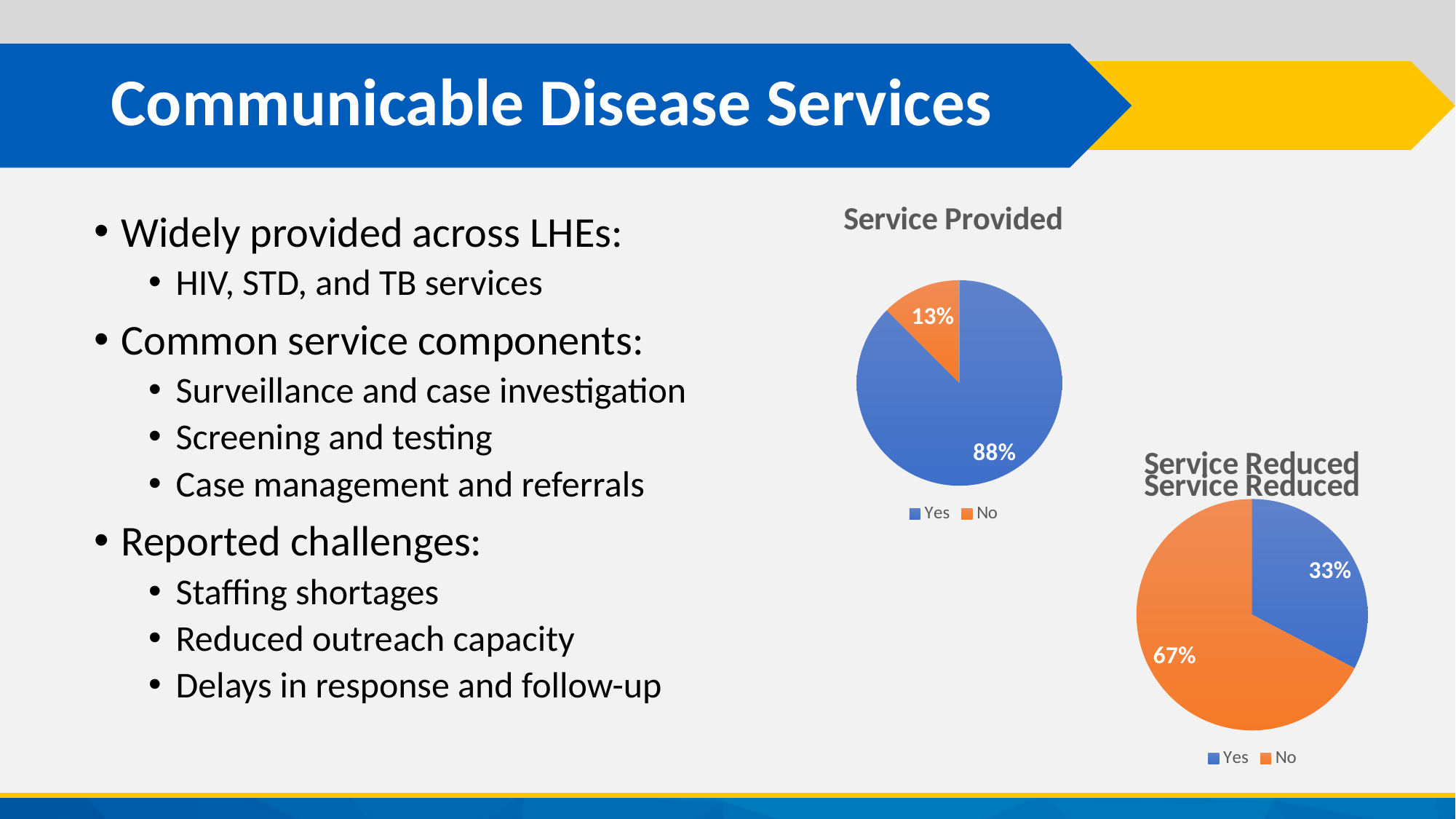
In the 'Service Provided' chart, what colour is the No slice? Orange In the 'Service Provided' chart, which slice is the largest? Yes What type of chart is the 'Service Provided' chart? Pie chart In the 'Service Provided' chart, what percentage is labelled for Yes? 88% In the 'Service Provided' chart, what is the difference in percentage points between the Yes and No slices? 75 In the 'Service Reduced' chart, which slice is the smallest? Yes In the 'Service Reduced' chart, which is larger, Yes or No? No In the 'Service Provided' chart, what percentage is labelled for No? 13% In the 'Service Reduced' chart, what percentage is labelled for Yes? 33% In the 'Service Reduced' chart, what is the difference in percentage points between the No and Yes slices? 34 In the 'Service Reduced' chart, what percentage is labelled for No? 67% How many entries does the legend of the 'Service Reduced' chart list? 2